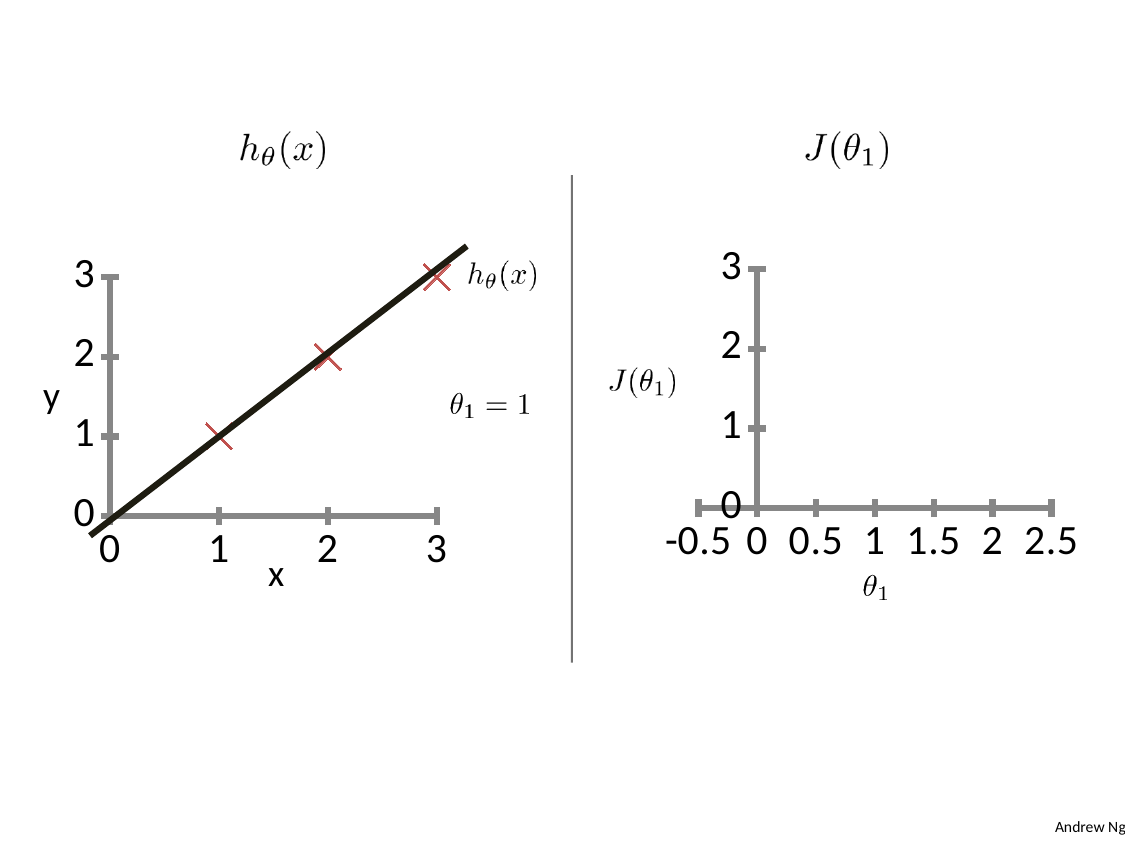
On the left chart titled h_θ(x), which x value has the highest y value? 3 On the left chart titled h_θ(x), what is the y value of the data point at x = 3? 3 On the right chart titled J(θ1), how many data points are plotted? 0 On the left chart titled h_θ(x), what is the difference between the y values at x = 3 and x = 1? 2 On the left chart titled h_θ(x), what is the y value of the data point at x = 1? 1 On the left chart titled h_θ(x), what value of θ1 is annotated next to the line? θ1 = 1 On the left chart titled h_θ(x), which x value has the lowest y value? 1 On the left chart titled h_θ(x), do the y values rise or fall as x increases? rise On the left chart titled h_θ(x), what is the y value of the data point at x = 2? 2 On the left chart titled h_θ(x), how many data points (red crosses) are plotted? 3 On the left chart titled h_θ(x), which is larger: the y value at x = 2 or at x = 1? x = 2 On the right chart titled J(θ1), what is the label of the horizontal axis? θ1